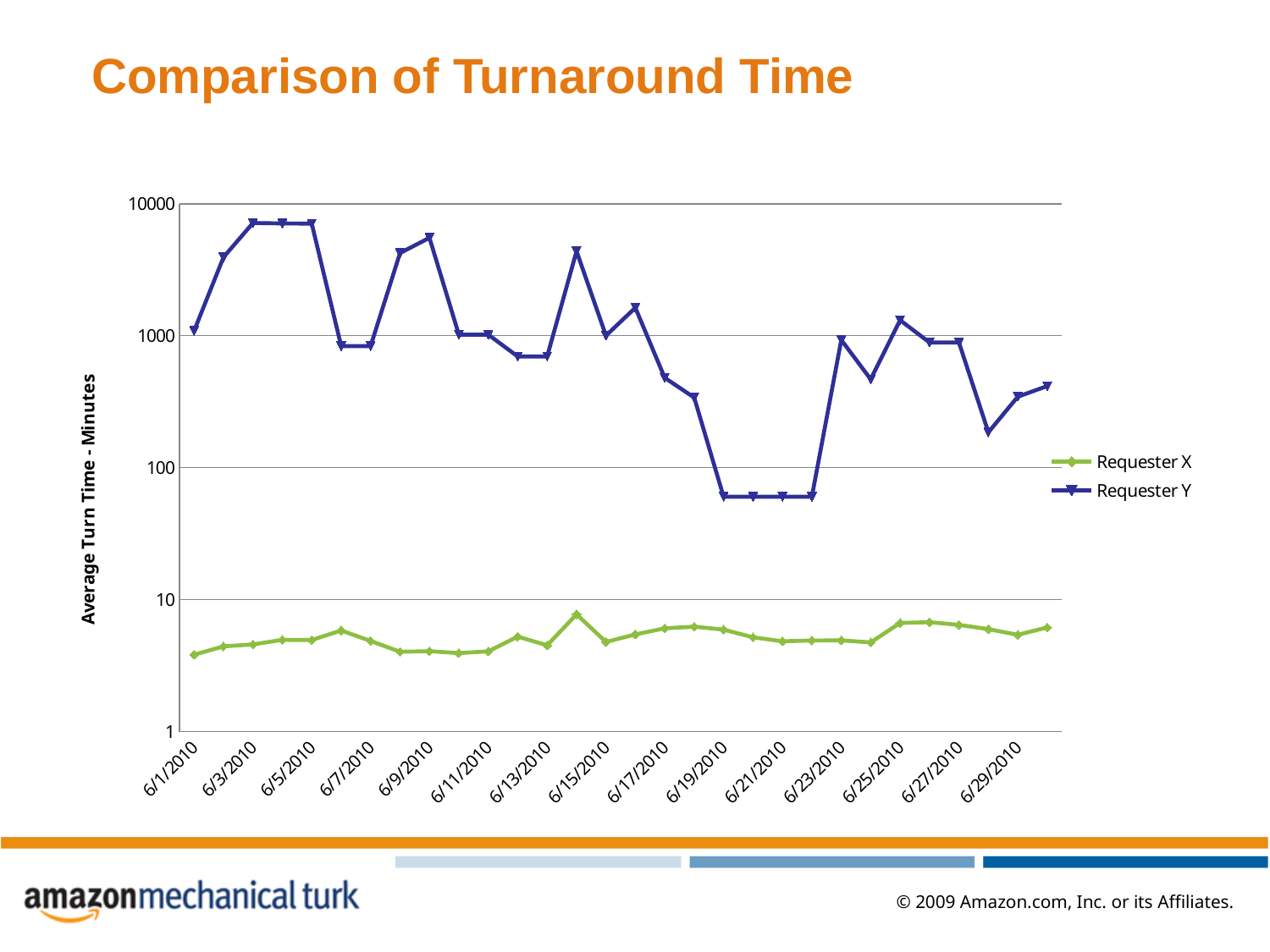
Is the value for Requester Y on 6/29/2010 greater or less than 1000? less How many series does the legend list? 2 Do the values for Requester Y rise or fall between 6/21/2010 and 6/23/2010? rise What kind of chart is shown on the slide? Line chart Is the value for Requester Y on 6/3/2010 greater or less than 1000? greater Is the value for Requester Y on 6/19/2010 greater or less than 100? less On 6/15/2010, which series has the larger value, Requester X or Requester Y? Requester Y What are the two series named in the legend? Requester X and Requester Y On which date does Requester X reach its highest value? 6/14/2010 What is the label on the vertical axis? Average Turn Time - Minutes Do the values for Requester Y rise or fall between 6/15/2010 and 6/19/2010? fall